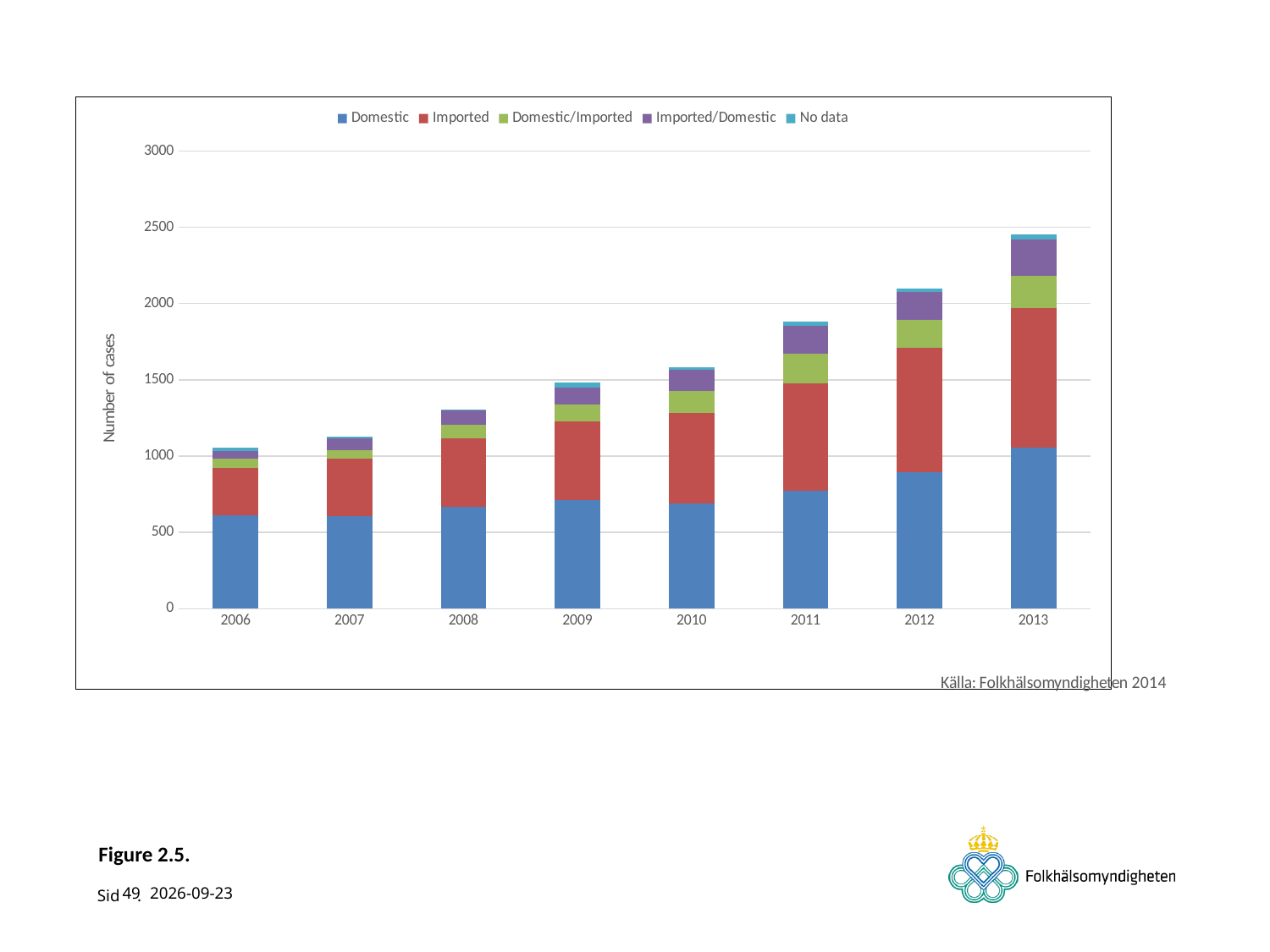
Which year has the larger total number of cases, 2006 or 2013? 2013 Which year has the lowest total number of cases? 2006 Is the Domestic value for 2006 greater or less than 500? greater Is the total number of cases for 2013 greater or less than 2000? greater How many series does the legend list? 5 How many years are shown on the x axis of the chart? 8 Which year has the highest total number of cases? 2013 What is the label on the y axis of the chart? Number of cases What kind of chart is shown on the slide? Stacked bar chart Is the total number of cases for 2011 greater or less than 2000? less Do the total number of cases generally rise or fall from 2006 to 2013? Rise